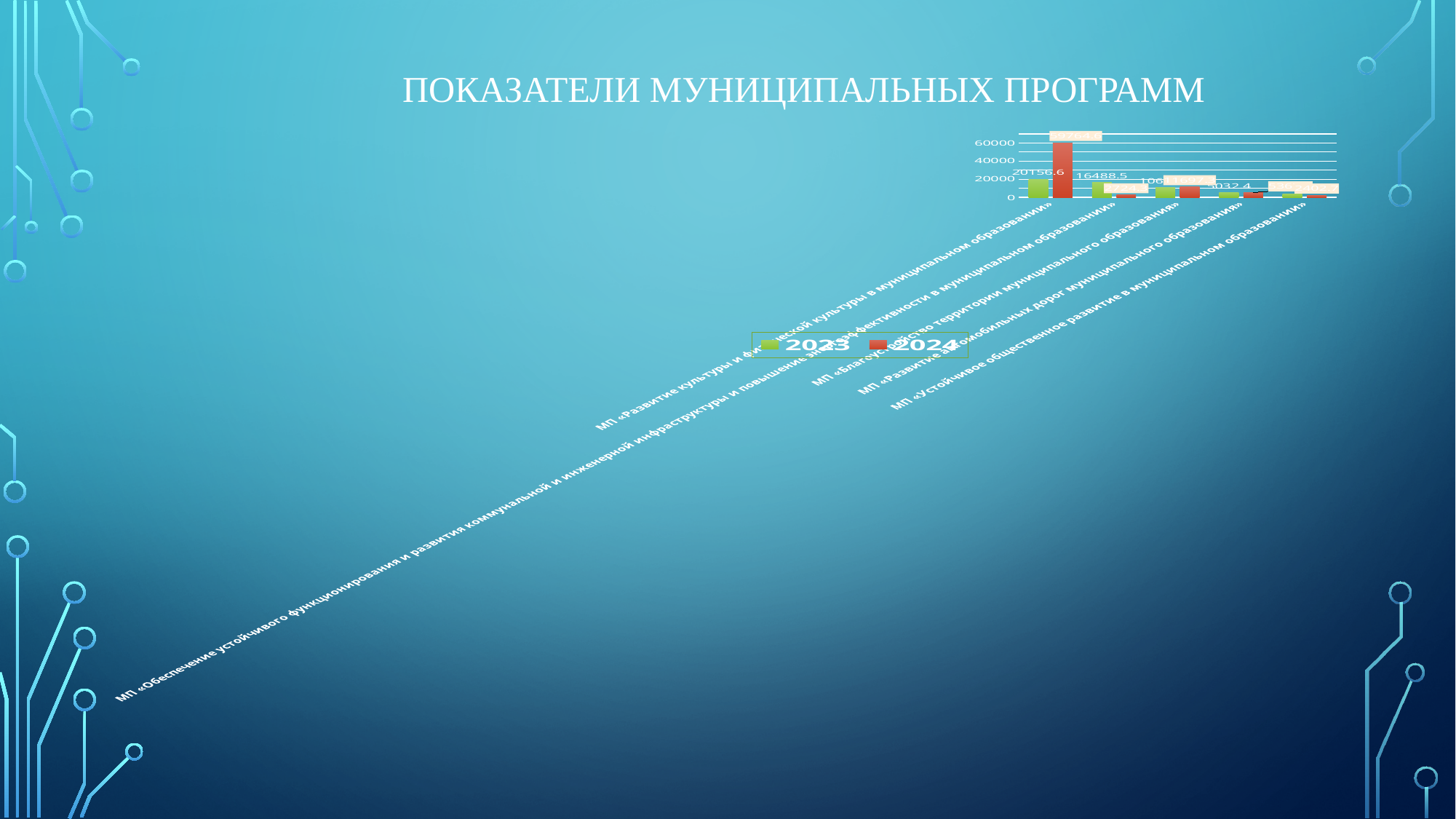
Is the 2024 value for the first (leftmost) programme category greater or less than 60000? less Which bar is the highest on the chart? 2024 for the first (leftmost) programme category What is the 2023 value for МП «Развитие автомобильных дорог муниципального образования»? 5032.4 What are the two series named in the legend? 2023 and 2024 What kind of chart is shown on the slide? bar chart What is the title of the slide containing the chart? ПОКАЗАТЕЛИ МУНИЦИПАЛЬНЫХ ПРОГРАММ How many series does the legend list? 2 What is the difference between the 2023 value of the first programme category (20156.6) and the 2023 value of the second programme category (16488.5)? 3668.1 What is the 2023 value for the first (leftmost) programme category? 20156.6 How many categories (municipal programmes) are plotted on the chart? 5